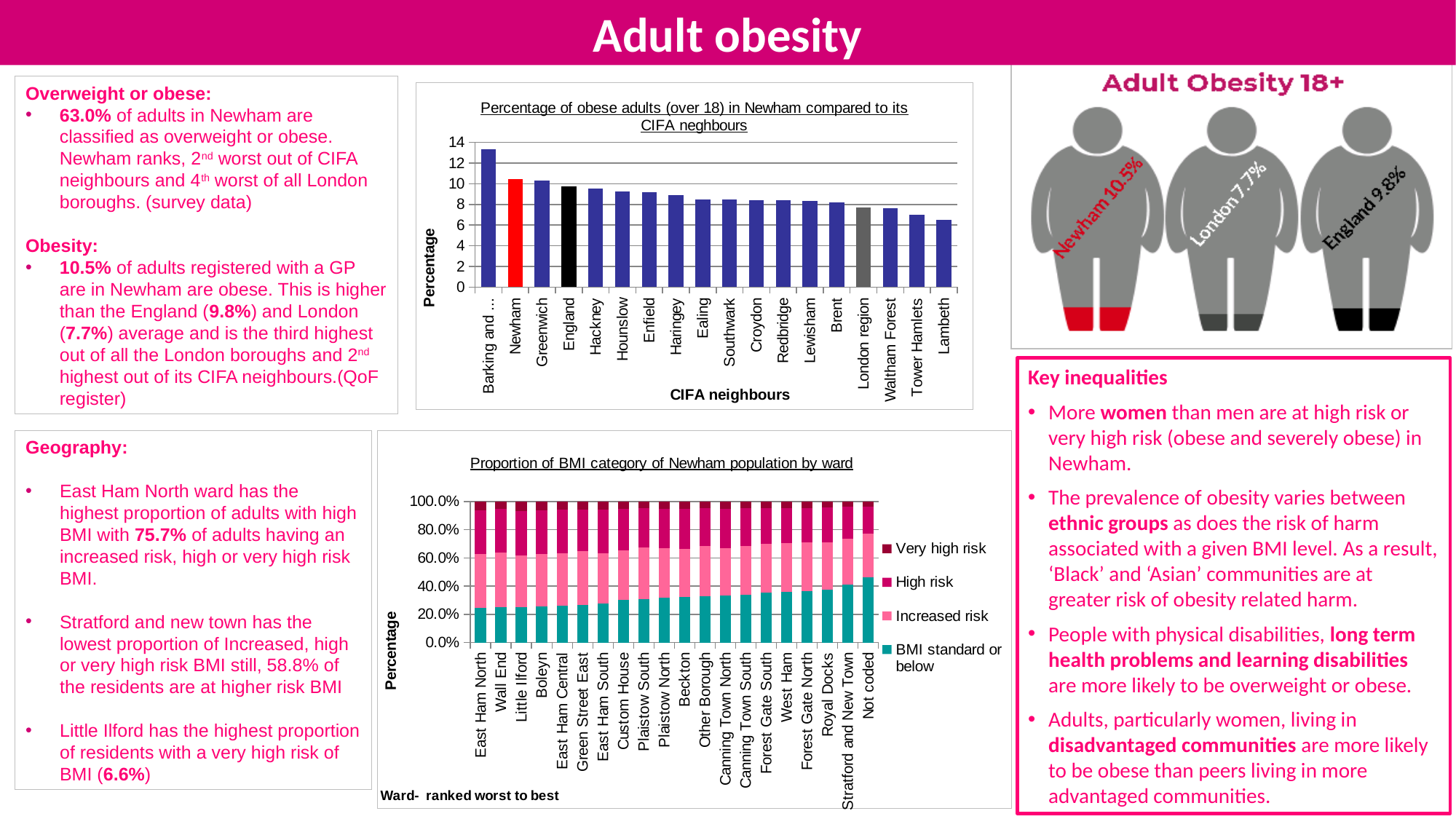
In the bottom chart, 'Proportion of BMI category of Newham population by ward', how many series does the legend list? 4 In the top chart, 'Percentage of obese adults (over 18) in Newham compared to its CIFA neghbours', is the value for Newham greater or less than 10? greater In the top chart, 'Percentage of obese adults (over 18) in Newham compared to its CIFA neghbours', what kind of chart is used? Bar chart In the top chart, 'Percentage of obese adults (over 18) in Newham compared to its CIFA neghbours', how many bars (areas) are plotted? 18 In the top chart, 'Percentage of obese adults (over 18) in Newham compared to its CIFA neghbours', is the value for Lambeth greater or less than 8? less In the top chart, 'Percentage of obese adults (over 18) in Newham compared to its CIFA neghbours', which has the larger value, Newham or England? Newham In the top chart, 'Percentage of obese adults (over 18) in Newham compared to its CIFA neghbours', which area has the lowest percentage? Lambeth In the bottom chart, 'Proportion of BMI category of Newham population by ward', what is the label of the x axis? Ward- ranked worst to best In the bottom chart, 'Proportion of BMI category of Newham population by ward', does the 'BMI standard or below' share rise or fall from left to right? Rise In the top chart, 'Percentage of obese adults (over 18) in Newham compared to its CIFA neghbours', do the bar values rise or fall from left to right? Fall In the bottom chart, 'Proportion of BMI category of Newham population by ward', how many wards (categories) are shown on the x axis? 20 In the top chart, 'Percentage of obese adults (over 18) in Newham compared to its CIFA neghbours', which area has the highest percentage? Barking and ...